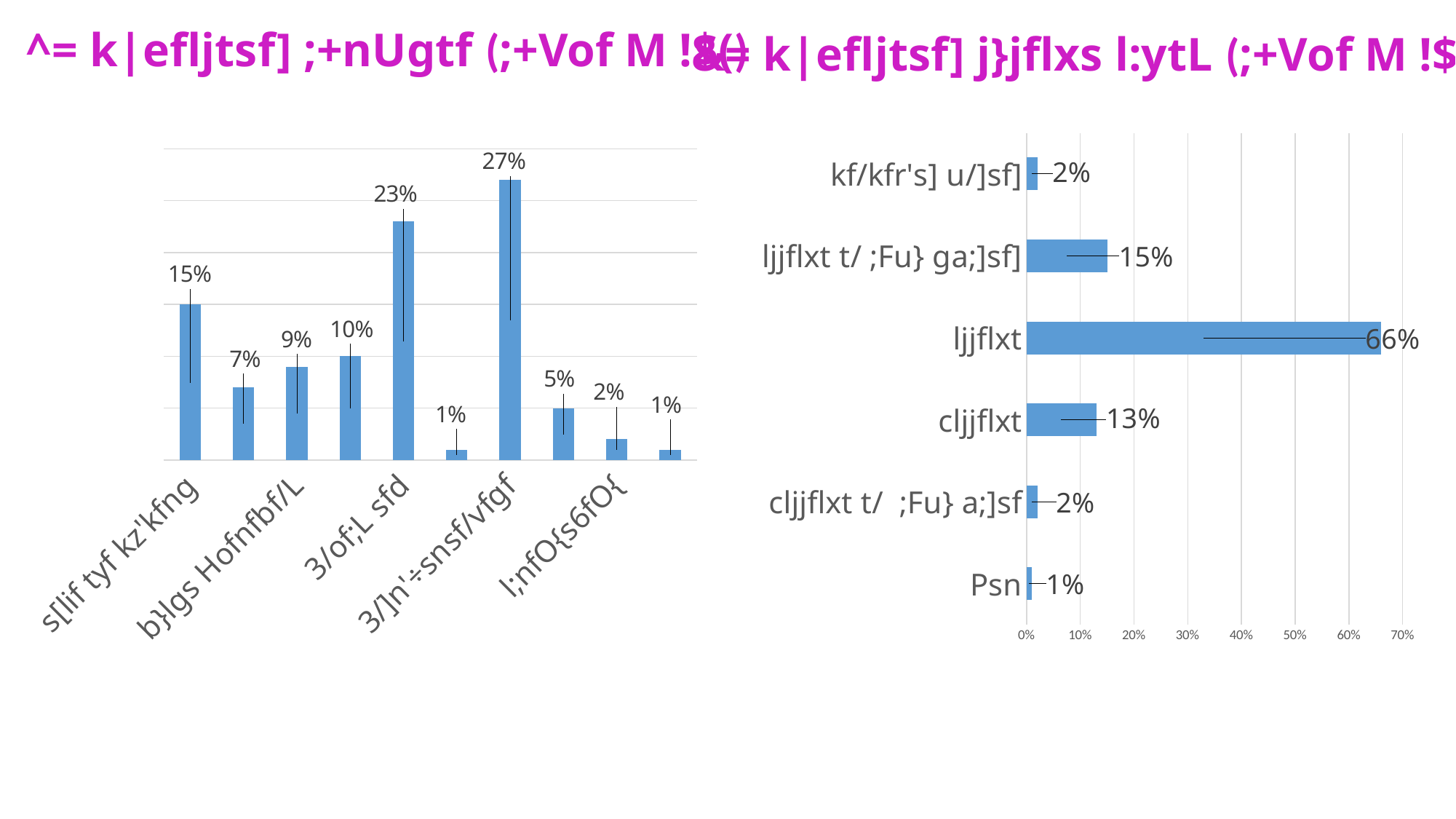
In the right chart, which category has the highest value? ljjflxt In the right chart, which category has the lowest value? Psn In the right chart, what is the value for "ljjflxt"? 66% How many categories are shown in the right chart? 6 In the right chart, which is larger: the value for "ljjflxt t/ ;Fu} ga;]sf]" or the value for "cljjflxt"? ljjflxt t/ ;Fu} ga;]sf] What kind of chart is the right chart? bar chart In the left chart, what is the difference between the two highest values, 27% and 23%? 4% In the left chart, what is the value of the first bar, labelled "s[lif tyf kz'kfng"? 15% In the left chart, what is the highest value shown? 27% How many bars are shown in the left chart? 10 In the right chart, what is the difference between the values for "ljjflxt" and "cljjflxt"? 53% In the right chart, what is the value for "Psn"? 1%